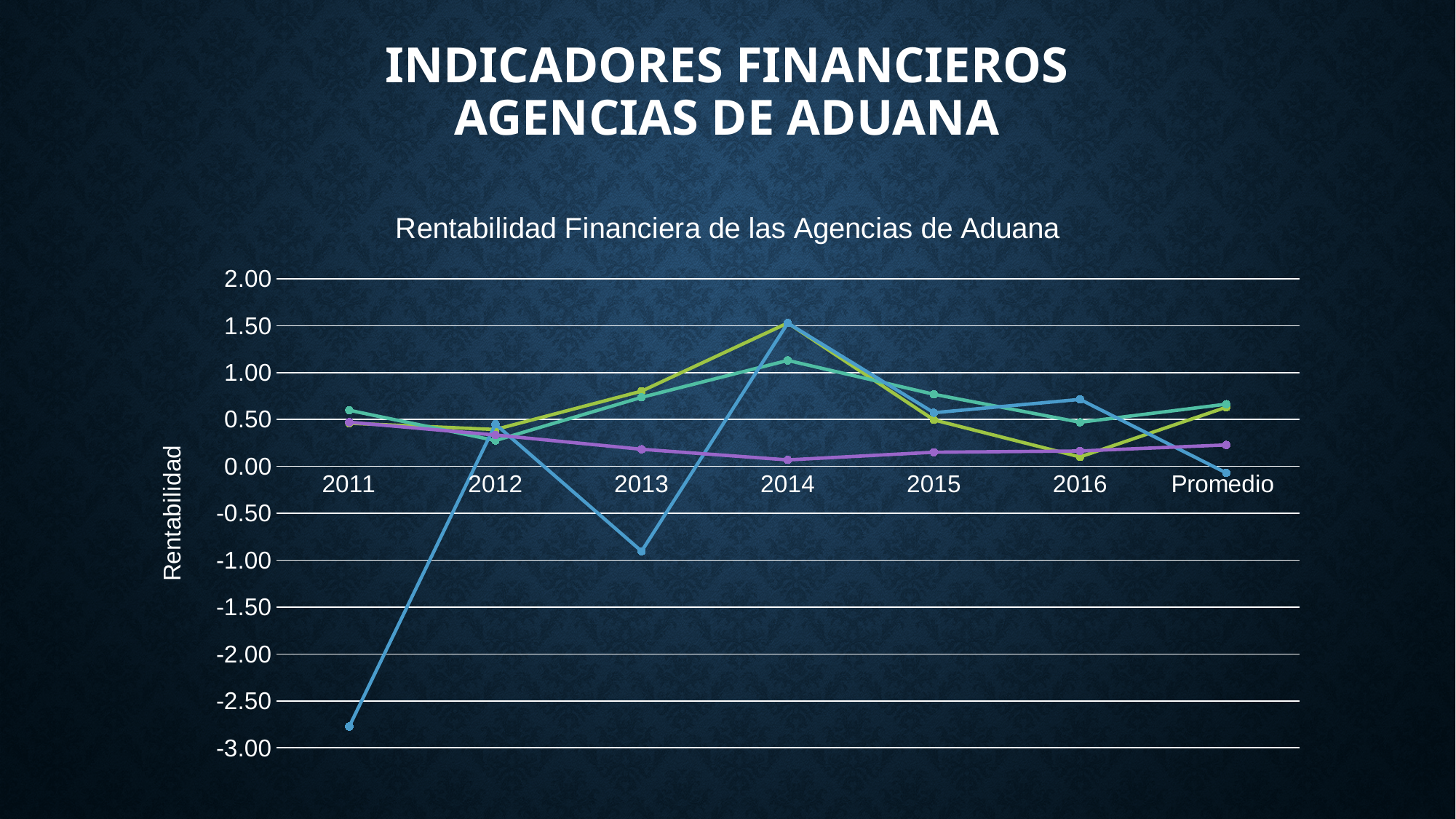
What is the label on the vertical axis of the chart? Rentabilidad Does the purple line rise or fall from 2011 to 2014? fall Is the value of the teal line for 2014 greater or less than 1.00? greater Is the value of the blue line for 2014 greater or less than 1.00? greater Is the value of the purple line for 2014 greater or less than 0.50? less Which year has the lowest value on the blue line? 2011 What is the title of the chart? Rentabilidad Financiera de las Agencias de Aduana Which is larger for 2013: the value of the blue line or the value of the purple line? purple line How many categories are shown along the x axis of the chart? 7 What kind of chart is shown on the slide? line chart